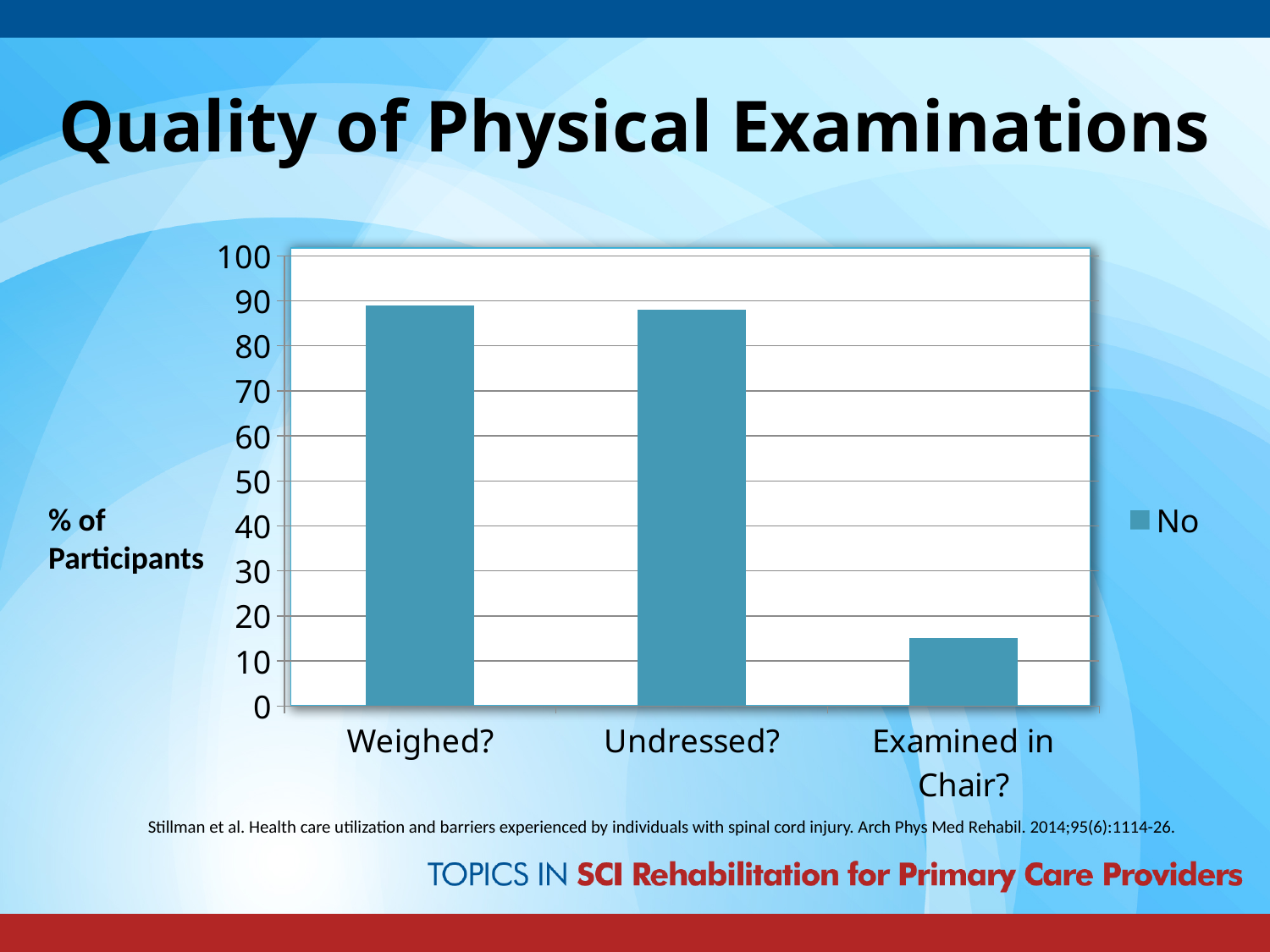
What kind of chart is shown on the slide? bar chart Is the value for Weighed? greater or less than 80? greater What is the label on the vertical axis of the chart? % of Participants Is the value for Examined in Chair? greater or less than 10? greater How many categories are shown on the x axis of the chart? 3 Which is larger, the value for Weighed? or the value for Examined in Chair? Weighed? Is the value for Examined in Chair? greater or less than 20? less Which category has the lowest value in the chart? Examined in Chair? Which is larger, the value for Undressed? or the value for Examined in Chair? Undressed? How many series does the chart's legend list? 1 What is the name of the series shown in the chart's legend? No